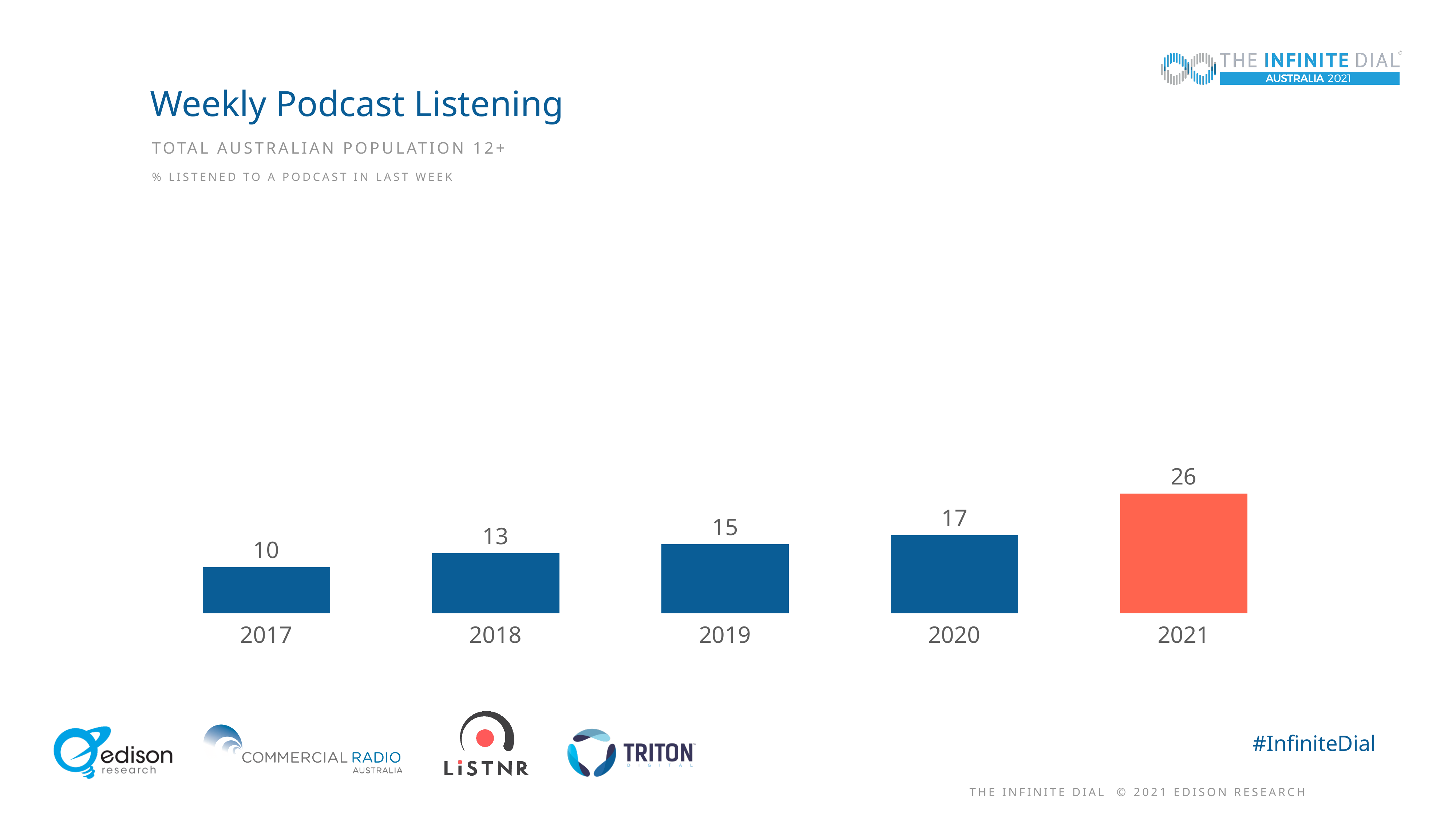
What is the title of the chart? Weekly Podcast Listening Which year has the lowest value? 2017 What is the difference between the values for 2018 and 2017? 3 What is the value for 2017? 10 How many years are shown on the chart? 5 Which year has the highest value? 2021 What is the value for 2021? 26 What is the value for 2019? 15 What kind of chart is shown on the slide? Bar chart Which is larger, the value for 2019 or the value for 2020? 2020 Do the values rise or fall from 2017 to 2021? Rise What is the difference between the values for 2021 and 2020? 9